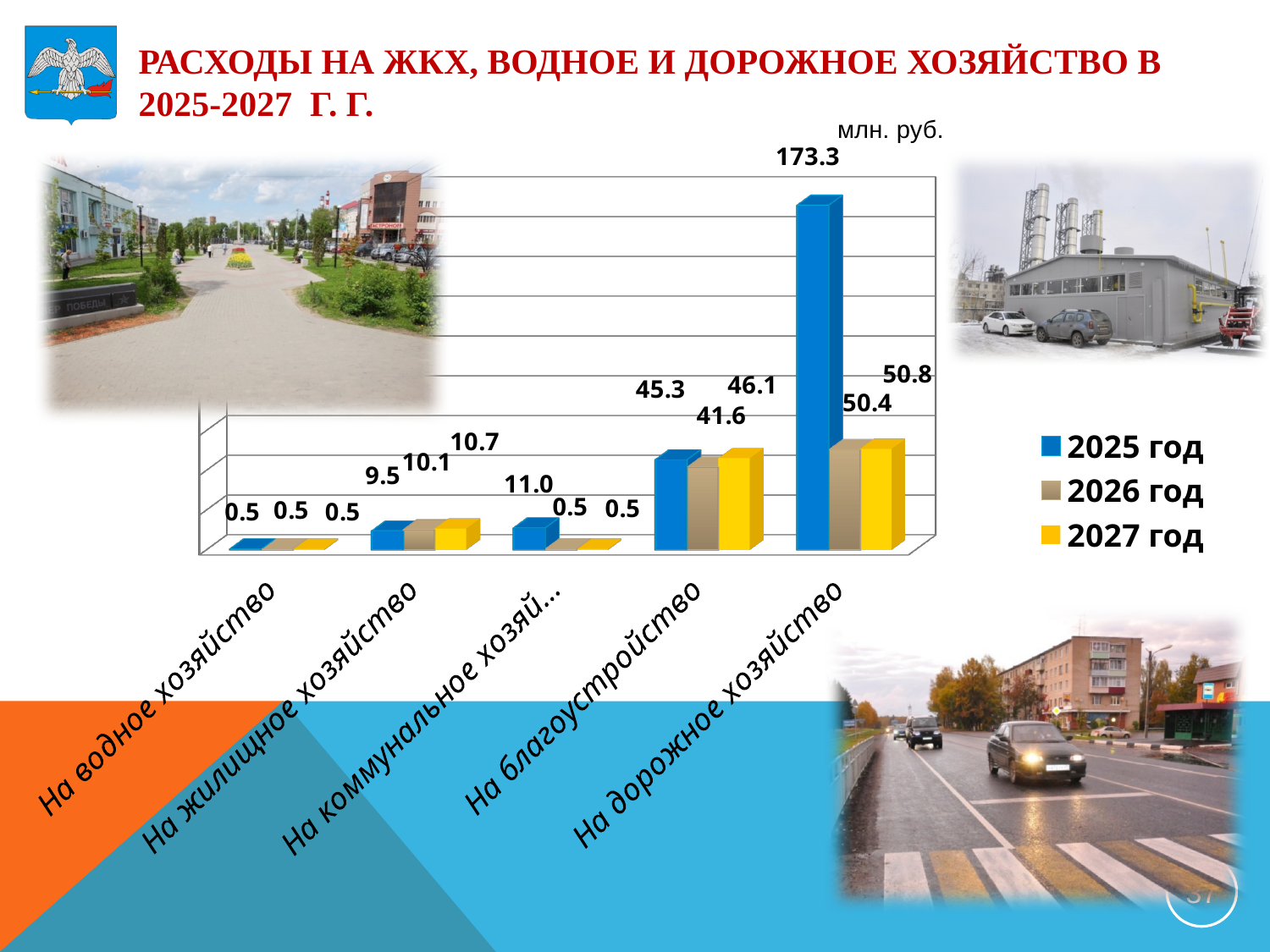
What is the value for 2026 год for На благоустройство? 41.6 What unit is indicated above the chart? млн. руб. How many series does the legend list? 3 Which is larger for На благоустройство: the 2025 год value or the 2027 год value? 2027 год What type of chart is shown on the slide? bar chart What is the value for 2025 год for На дорожное хозяйство? 173.3 What is the value for 2025 год for На коммунальное хозяйство? 11.0 Which category has the highest value for 2025 год? На дорожное хозяйство What is the value for 2027 год for На жилищное хозяйство? 10.7 What is the difference between the 2025 год and 2026 год values for На дорожное хозяйство? 122.9 How many categories are shown on the x axis of the chart? 5